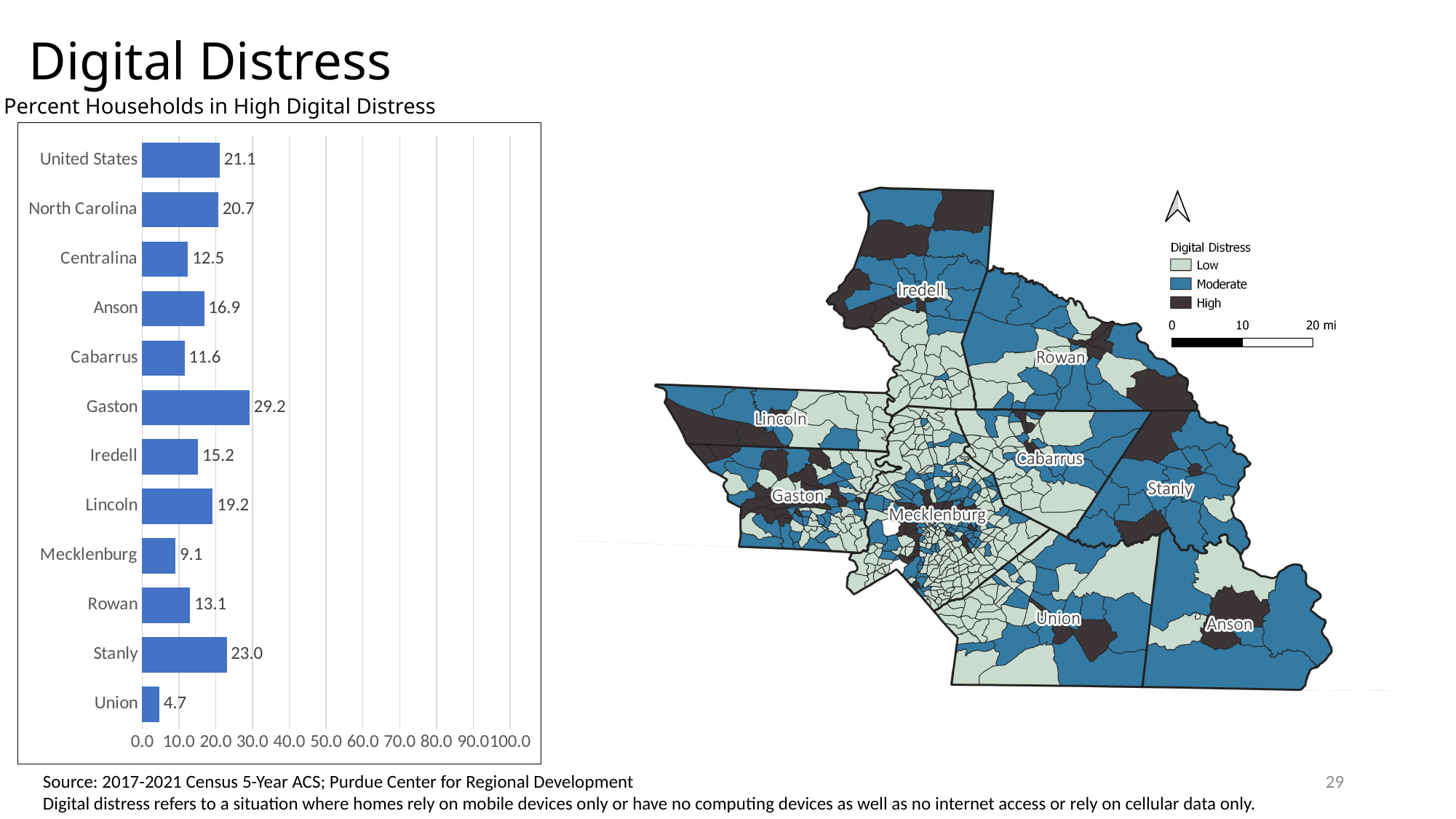
Which category has the highest percent of households in high digital distress? Gaston Is the value for Lincoln greater or less than 10.0? greater What is the value shown for Mecklenburg in the bar chart? 9.1 Which has a higher value, Anson or Iredell? Anson What is the value shown for North Carolina in the bar chart? 20.7 What is the maximum value shown on the x axis of the bar chart? 100.0 How many categories are shown in the bar chart? 12 What kind of chart is used to show percent households in high digital distress? bar chart What is the difference between the values for Stanly and Cabarrus? 11.4 Which category has the lowest percent of households in high digital distress? Union What is the percent of households in high digital distress for Gaston? 29.2 What is the difference between the United States value and the Centralina value? 8.6